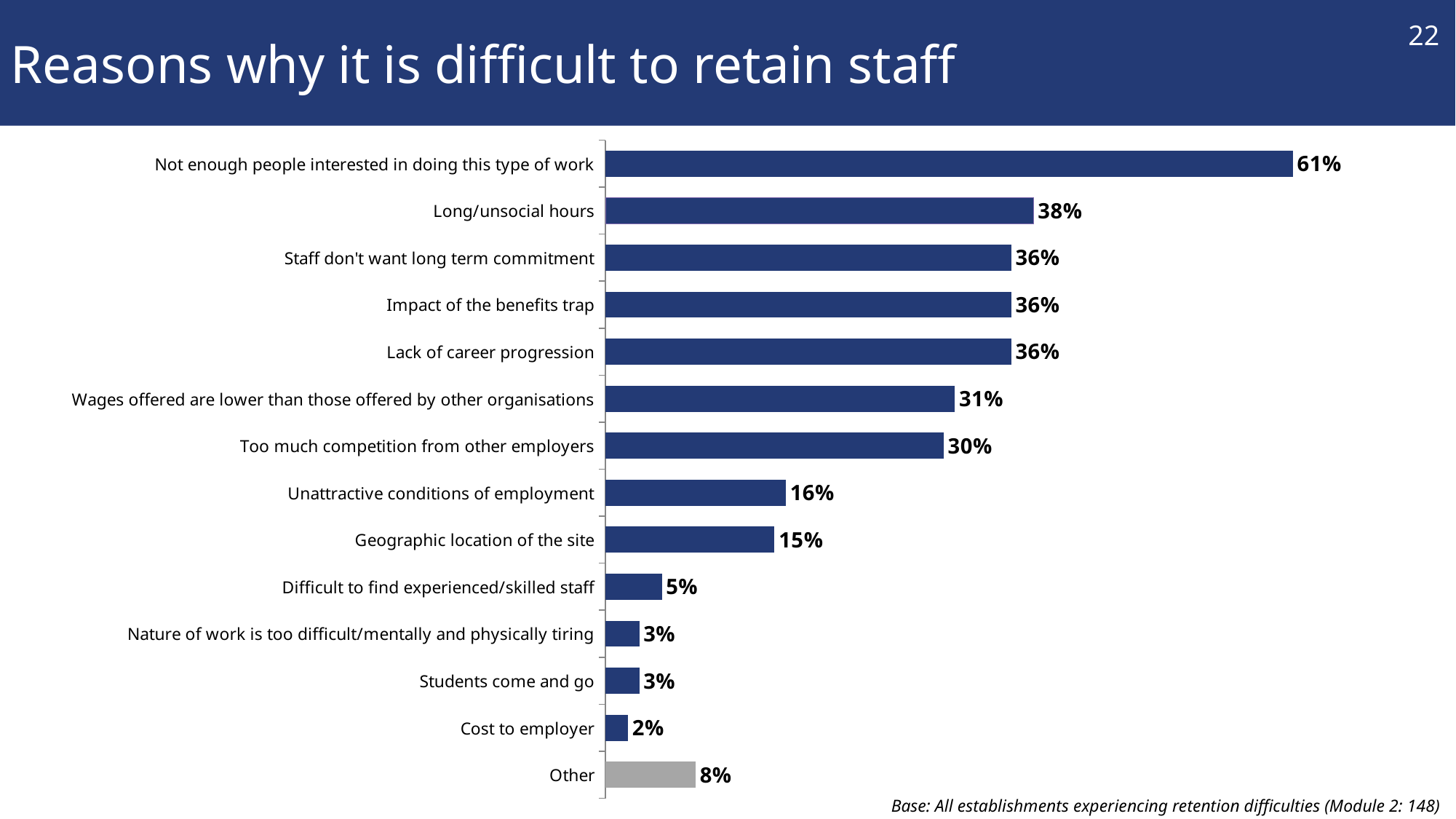
Which reason has the highest percentage? Not enough people interested in doing this type of work What is the value for 'Long/unsocial hours'? 38% How many reasons (categories) are shown in the chart? 14 What kind of chart is shown on the slide? Bar chart What is the difference between 'Not enough people interested in doing this type of work' and 'Long/unsocial hours'? 23% What is the difference between 'Unattractive conditions of employment' and 'Geographic location of the site'? 1% Which is larger: 'Wages offered are lower than those offered by other organisations' or 'Too much competition from other employers'? Wages offered are lower than those offered by other organisations What percentage is shown for 'Geographic location of the site'? 15% Which bar is coloured grey rather than dark blue? Other What is the value for 'Other'? 8% Which reason has the lowest percentage? Cost to employer What percentage is shown for 'Not enough people interested in doing this type of work'? 61%